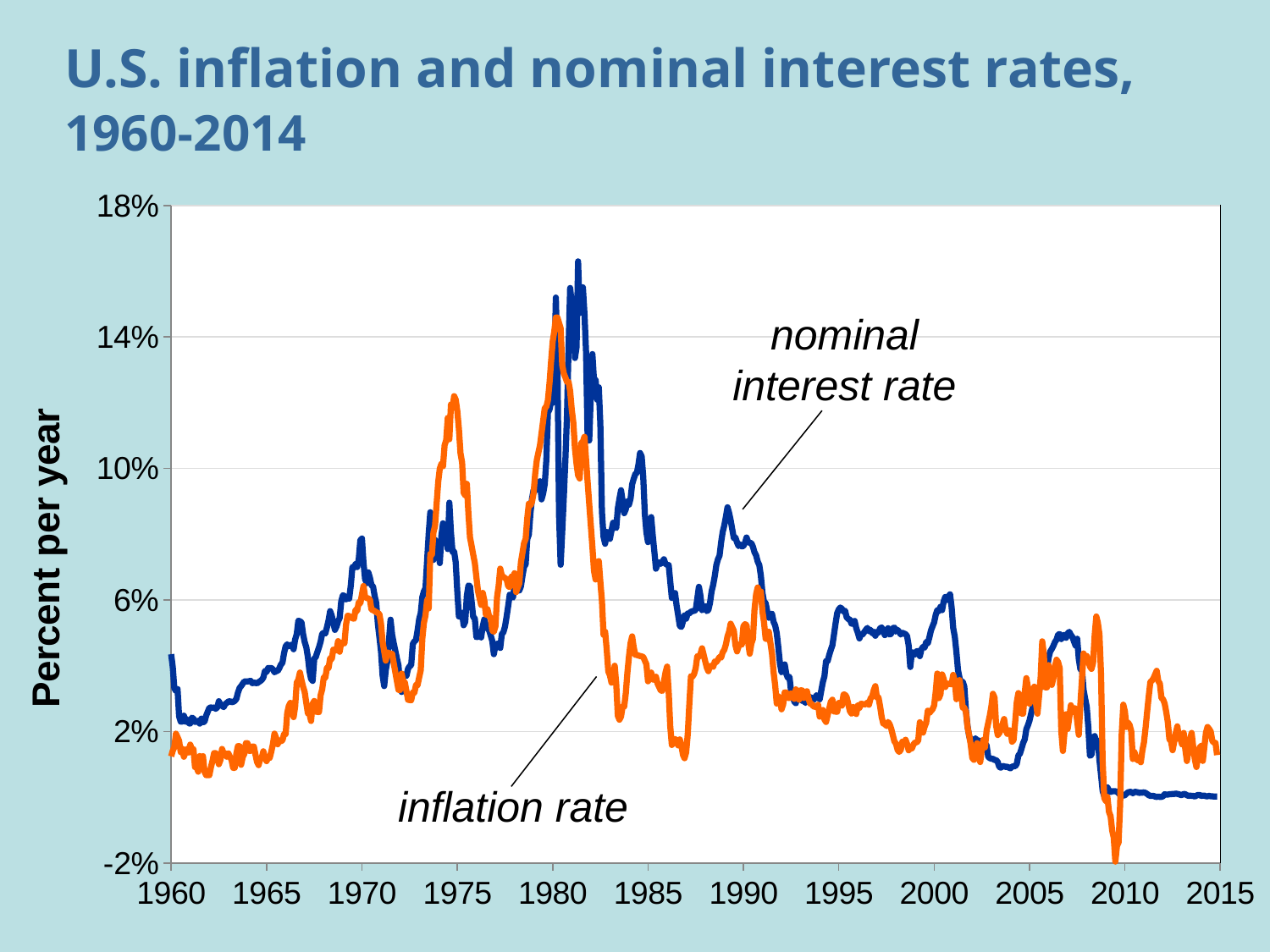
In 1995, which is higher: the nominal interest rate or the inflation rate? nominal interest rate Is the inflation rate in 1965 greater or less than 2%? less How many data series are plotted on the chart? 2 What is the title of the chart? U.S. inflation and nominal interest rates, 1960-2014 Which series reaches the highest value anywhere on the chart? nominal interest rate Is the nominal interest rate in 2014 greater or less than 2%? less Is the peak value of the nominal interest rate around 1981 greater or less than 14%? greater What is the label on the vertical axis? Percent per year What kind of chart is shown on the slide? line chart In 1975, which is higher: the inflation rate or the nominal interest rate? inflation rate